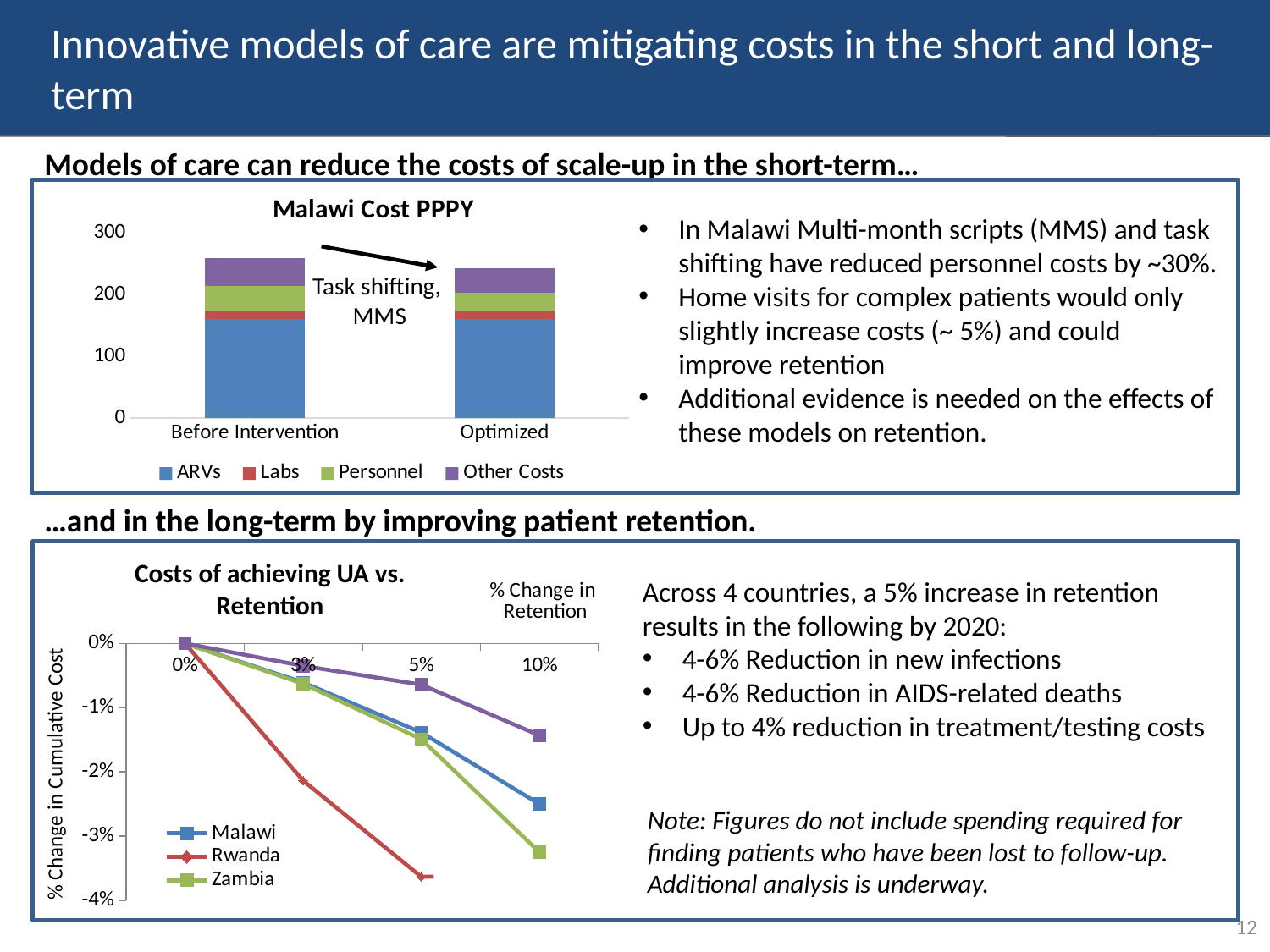
What kind of chart is the 'Malawi Cost PPPY' chart? Stacked bar chart In the 'Malawi Cost PPPY' chart, is the ARVs value for Before Intervention greater or less than 100? greater In the 'Malawi Cost PPPY' chart, is the total for Before Intervention greater or less than 200? greater In the 'Malawi Cost PPPY' chart, how many categories are shown on the x axis? 2 In the 'Malawi Cost PPPY' chart, how many series does the legend list? 4 What kind of chart is the 'Costs of achieving UA vs. Retention' chart? Line chart In the 'Costs of achieving UA vs. Retention' chart, which country has the lowest value at a 5% change in retention? Rwanda In the 'Malawi Cost PPPY' chart, which series is shown in purple? Other Costs In the 'Costs of achieving UA vs. Retention' chart, how many series does the legend list? 3 In the 'Malawi Cost PPPY' chart, which category has the higher total bar, Before Intervention or Optimized? Before Intervention In the 'Costs of achieving UA vs. Retention' chart, is the Malawi value at a 10% change in retention greater or less than -2%? less In the 'Costs of achieving UA vs. Retention' chart, do the values rise or fall as the % change in retention increases? Fall